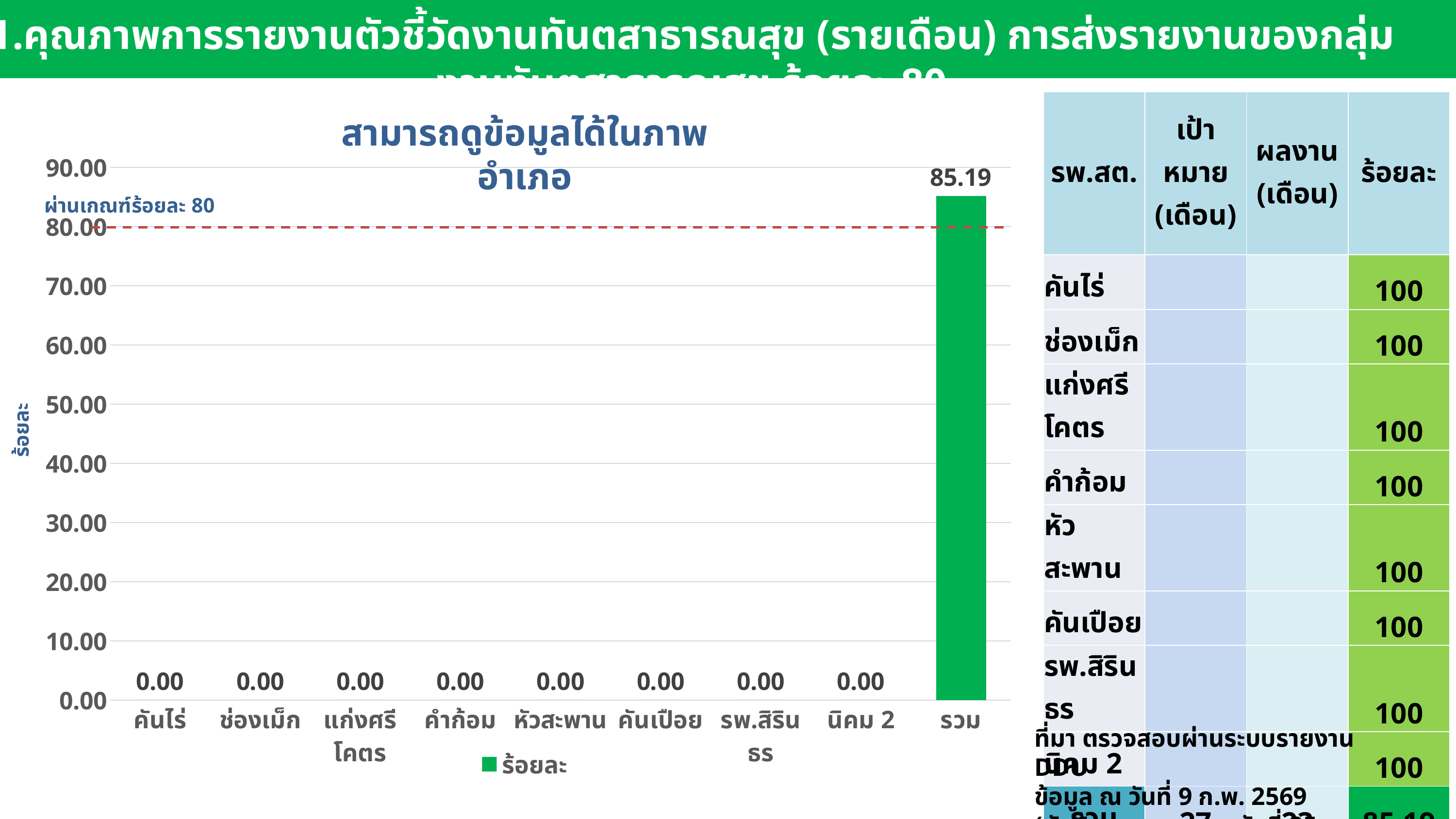
How many series does the chart legend list? 1 What is the value for นิคม 2 in the chart? 0.00 How many categories are shown on the x axis of the chart? 9 What is the name of the series shown in the chart legend? ร้อยละ Which is larger, the value for รวม or the value for หัวสะพาน? รวม What is the value for คันไร่ in the chart? 0.00 What is the value for รวม in the chart? 85.19 What is the difference between the value for รวม and the value for คำก้อม? 85.19 What is the label on the dashed red reference line in the chart? ผ่านเกณฑ์ร้อยละ 80 Which category has the highest value in the chart? รวม Is the value for รวม greater or less than 80? greater What kind of chart is shown on the slide? bar chart